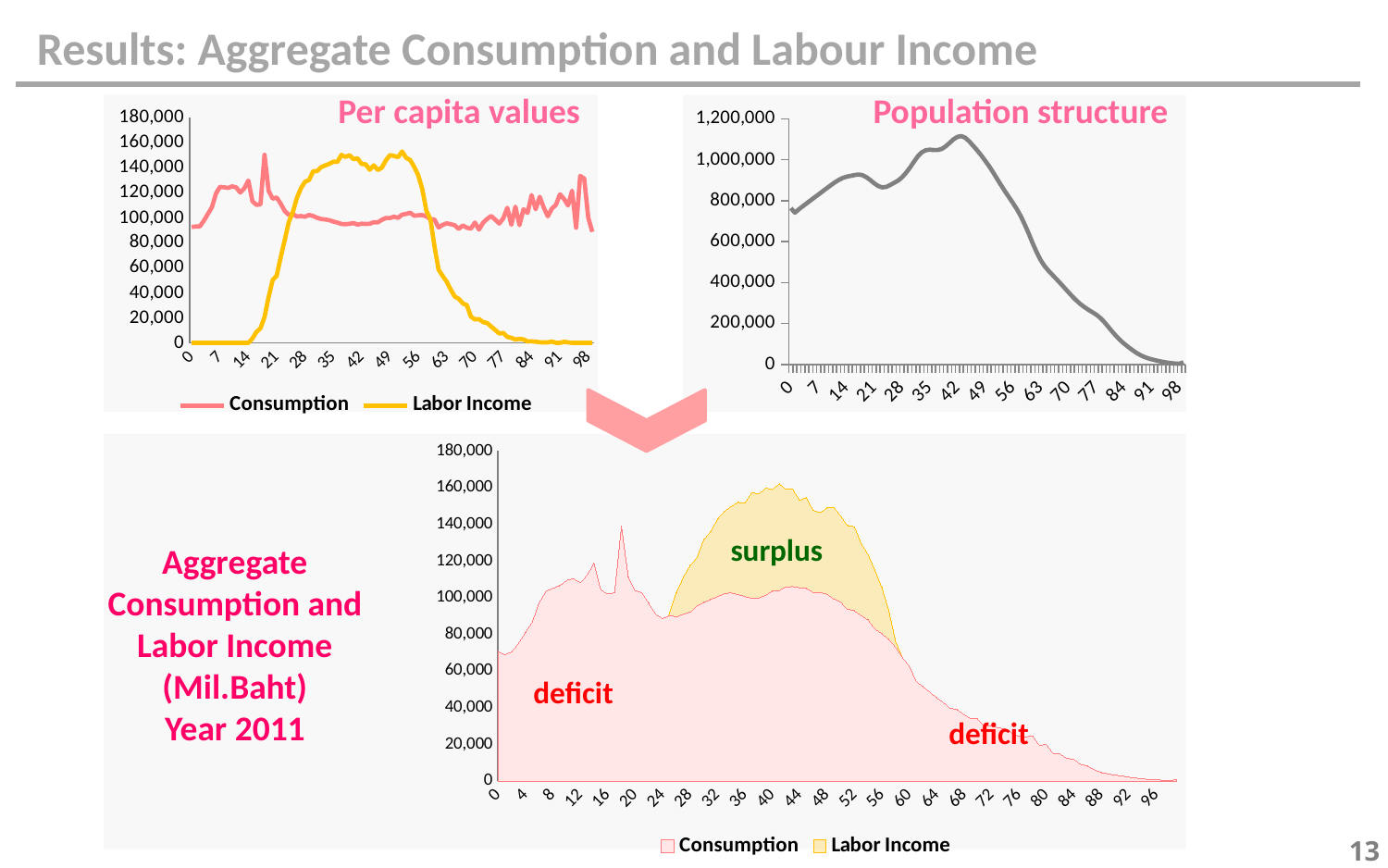
In the 'Population structure' chart, is the value at age 84 greater or less than 200,000? less In the 'Per capita values' chart, is the Consumption value at age 35 greater or less than 120,000? less In the 'Population structure' chart, is the value at age 42 greater or less than 1,000,000? greater What kind of chart is the bottom 'Aggregate Consumption and Labor Income' chart? area chart In the bottom 'Aggregate Consumption and Labor Income' chart, what word labels the region where Labor Income exceeds Consumption? surplus In the 'Per capita values' chart, which series is larger at age 42, Consumption or Labor Income? Labor Income In the 'Per capita values' chart, what is the Labor Income value at age 7? 0 In the 'Population structure' chart, do the values rise or fall between age 49 and age 98? fall What kind of chart is the 'Per capita values' chart? line chart How many series does the legend of the 'Per capita values' chart list? 2